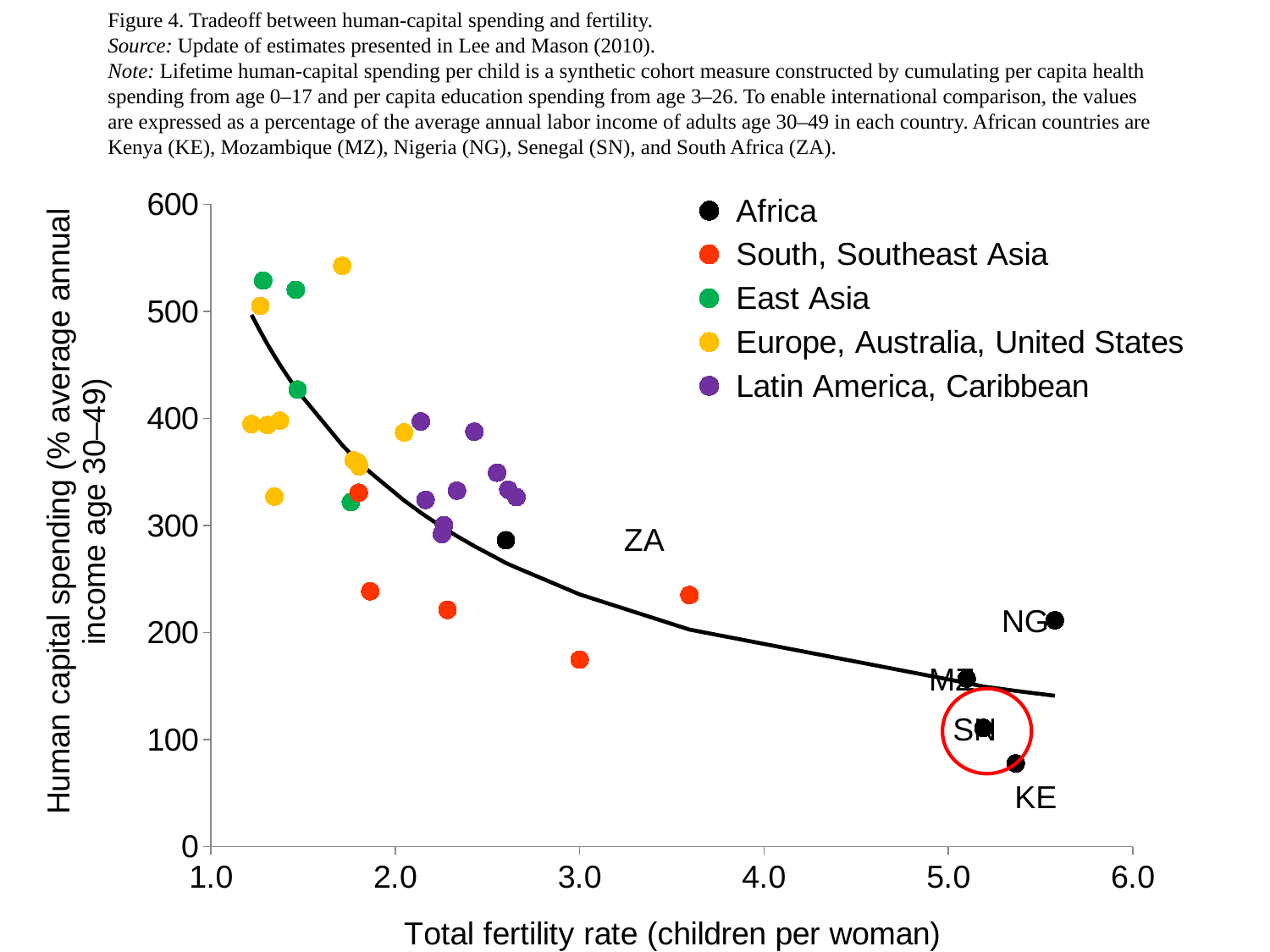
Which African country has the highest total fertility rate? NG Which African country has the lowest human capital spending? KE As the total fertility rate increases along the x axis, does human capital spending generally rise or fall? fall Is the human capital spending value for KE greater or less than 100? less Which African country has the highest human capital spending? ZA What kind of chart is shown on the slide? scatter chart Which country's point is circled in red? SN Is the human capital spending value for ZA greater or less than 300? less Which has higher human capital spending, ZA or KE? ZA Is the total fertility rate for NG greater or less than 5.0? greater How many series does the legend list? 5